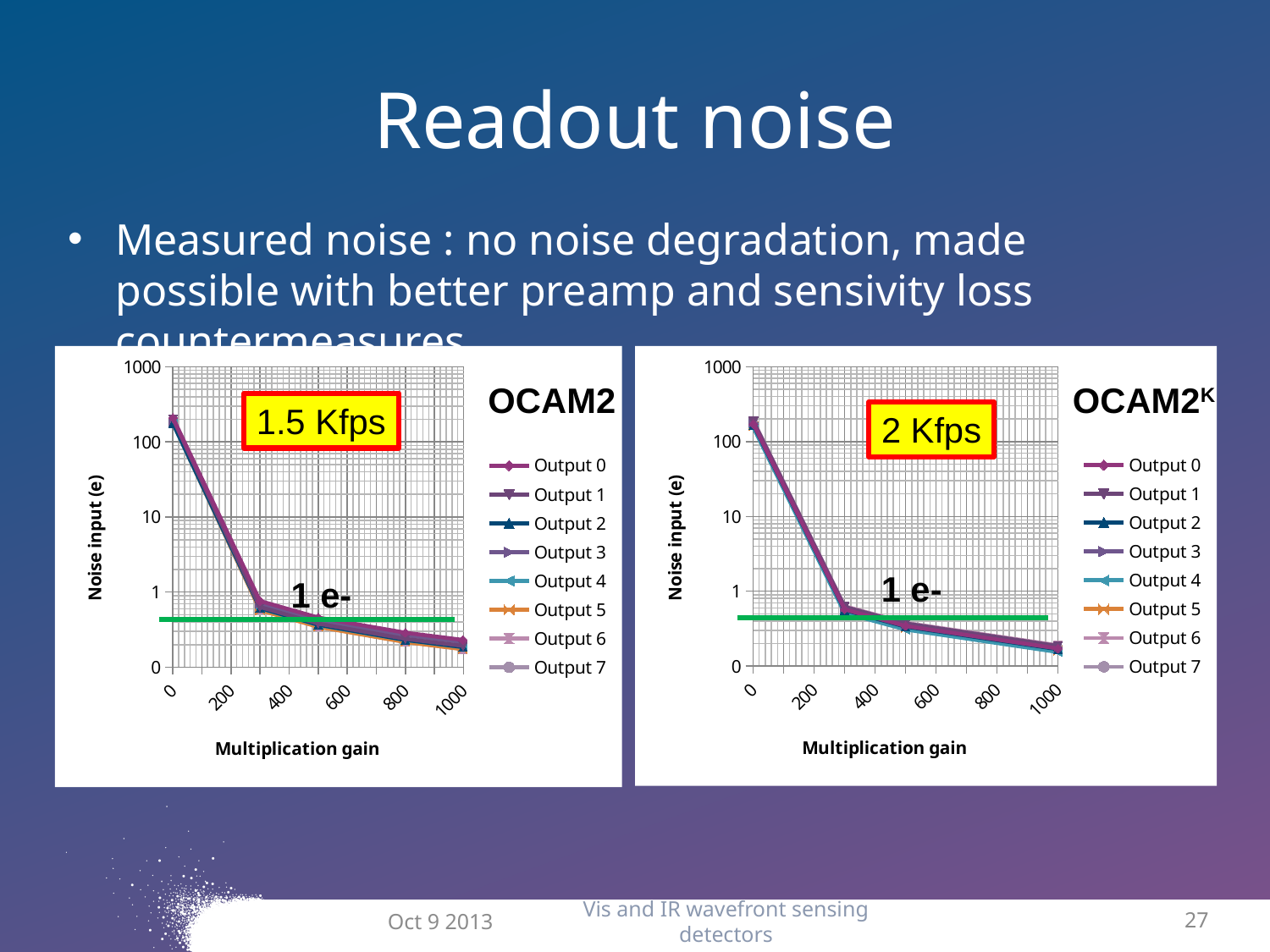
How many series does the legend of the left chart (OCAM2) list? 8 In the right chart (OCAM2K), is the noise input at multiplication gain 0 greater or less than 100? greater In the right chart (OCAM2K), do the noise values rise or fall as multiplication gain increases? fall What frame rate is shown in the yellow box on the right chart (OCAM2K)? 2 Kfps What is the x-axis label of the left chart (OCAM2)? Multiplication gain In the left chart (OCAM2), is the noise input at multiplication gain 0 greater or less than 100? greater In the right chart (OCAM2K), is the noise input at multiplication gain 1000 greater or less than 1? less How many series does the legend of the right chart (OCAM2K) list? 8 What kind of chart is the left chart (OCAM2)? line chart What kind of chart is the right chart (OCAM2K)? line chart In the left chart (OCAM2), do the noise values rise or fall as multiplication gain increases? fall